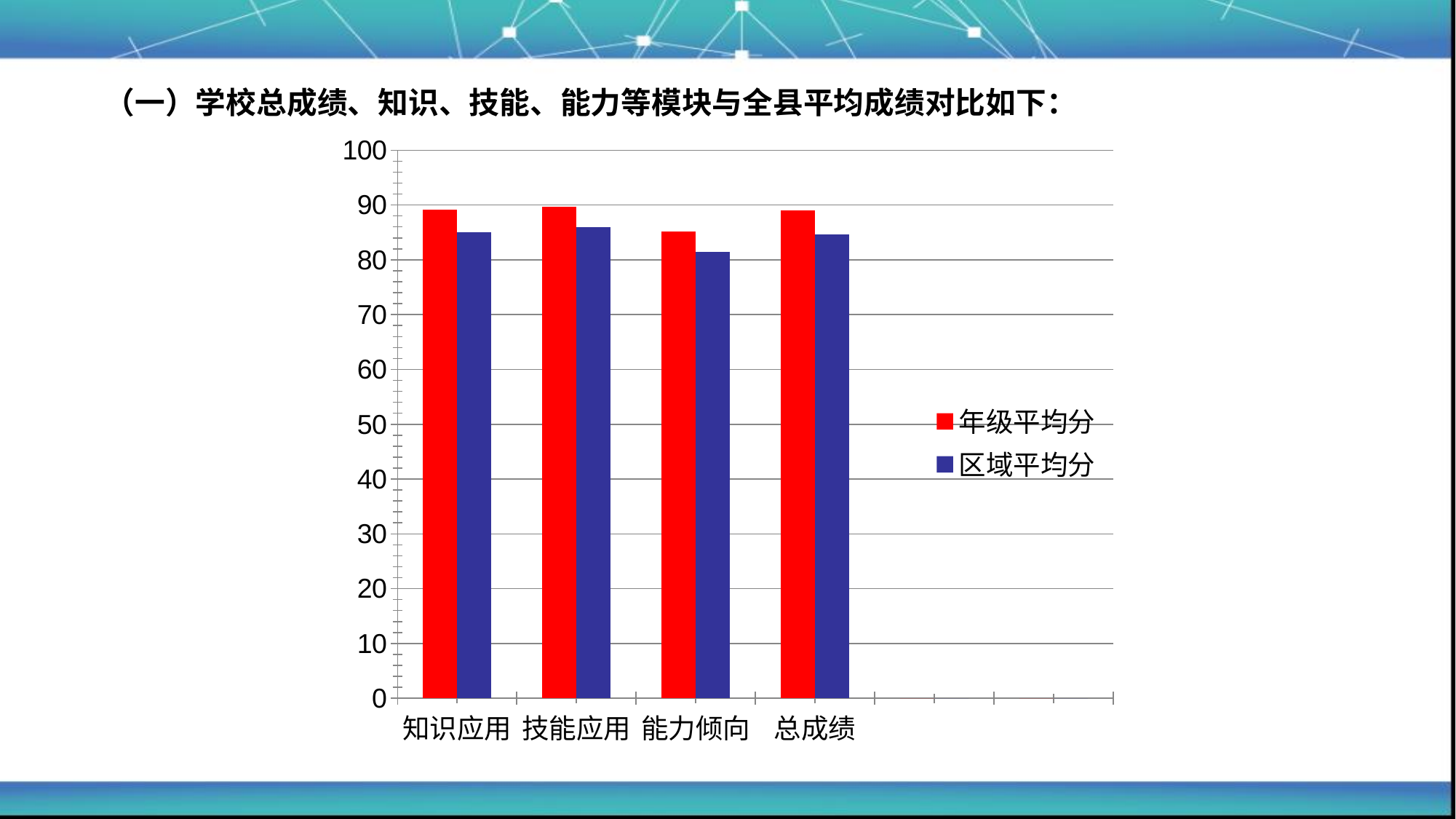
Which series is shown in red in the chart? 年级平均分 How many series does the chart's legend list? 2 Which category has the lowest 区域平均分 value? 能力倾向 For 总成绩, which is larger: 年级平均分 or 区域平均分? 年级平均分 Is the 区域平均分 value for 知识应用 greater or less than 70? greater Is the 区域平均分 value for 能力倾向 greater or less than 90? less How many categories are shown on the x axis of the chart? 4 Which category has the lowest 年级平均分 value? 能力倾向 Which series is shown in blue in the chart? 区域平均分 What kind of chart is shown on the slide? bar chart For 能力倾向, which is larger: 年级平均分 or 区域平均分? 年级平均分 Is the 年级平均分 value for 技能应用 greater or less than 80? greater